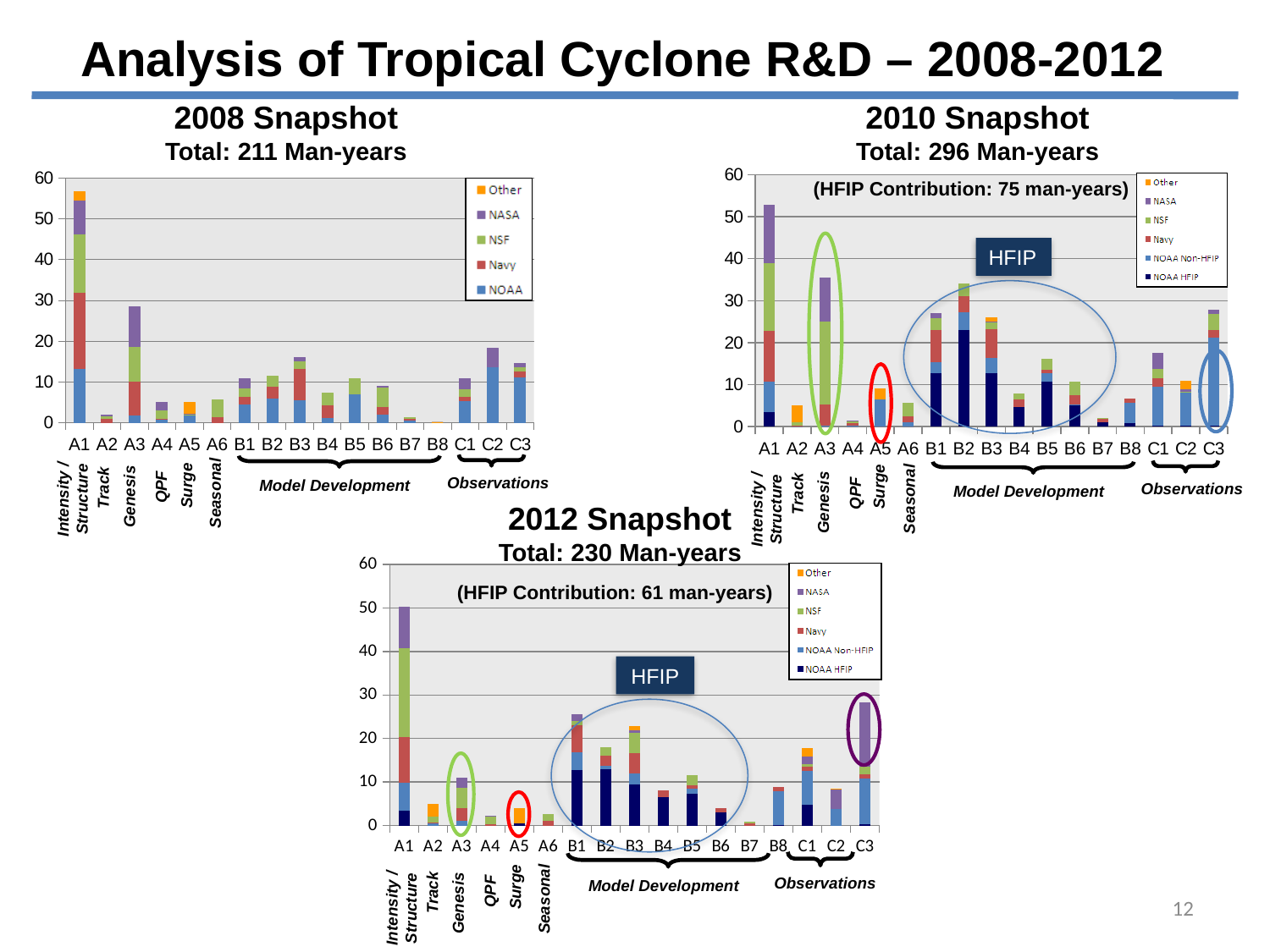
How many categories are shown on the x axis of the 2012 Snapshot chart? 17 In the 2012 Snapshot chart, which bar is taller, B1 or B2? B1 In the 2010 Snapshot chart, is the total value for B2 greater or less than 30? greater What HFIP contribution is stated on the 2010 Snapshot chart? 75 man-years In the 2012 Snapshot chart, which category has the tallest bar? A1 In the 2008 Snapshot chart, which category has the tallest bar? A1 What kind of chart is the 2008 Snapshot chart? Stacked bar chart In the 2008 Snapshot chart, is the total value for A1 greater or less than 50? greater How many series does the legend of the 2008 Snapshot chart list? 5 How many series does the legend of the 2010 Snapshot chart list? 6 In the 2010 Snapshot chart, which category has the tallest bar? A1 In the 2012 Snapshot chart, is the total value for C3 greater or less than 20? greater